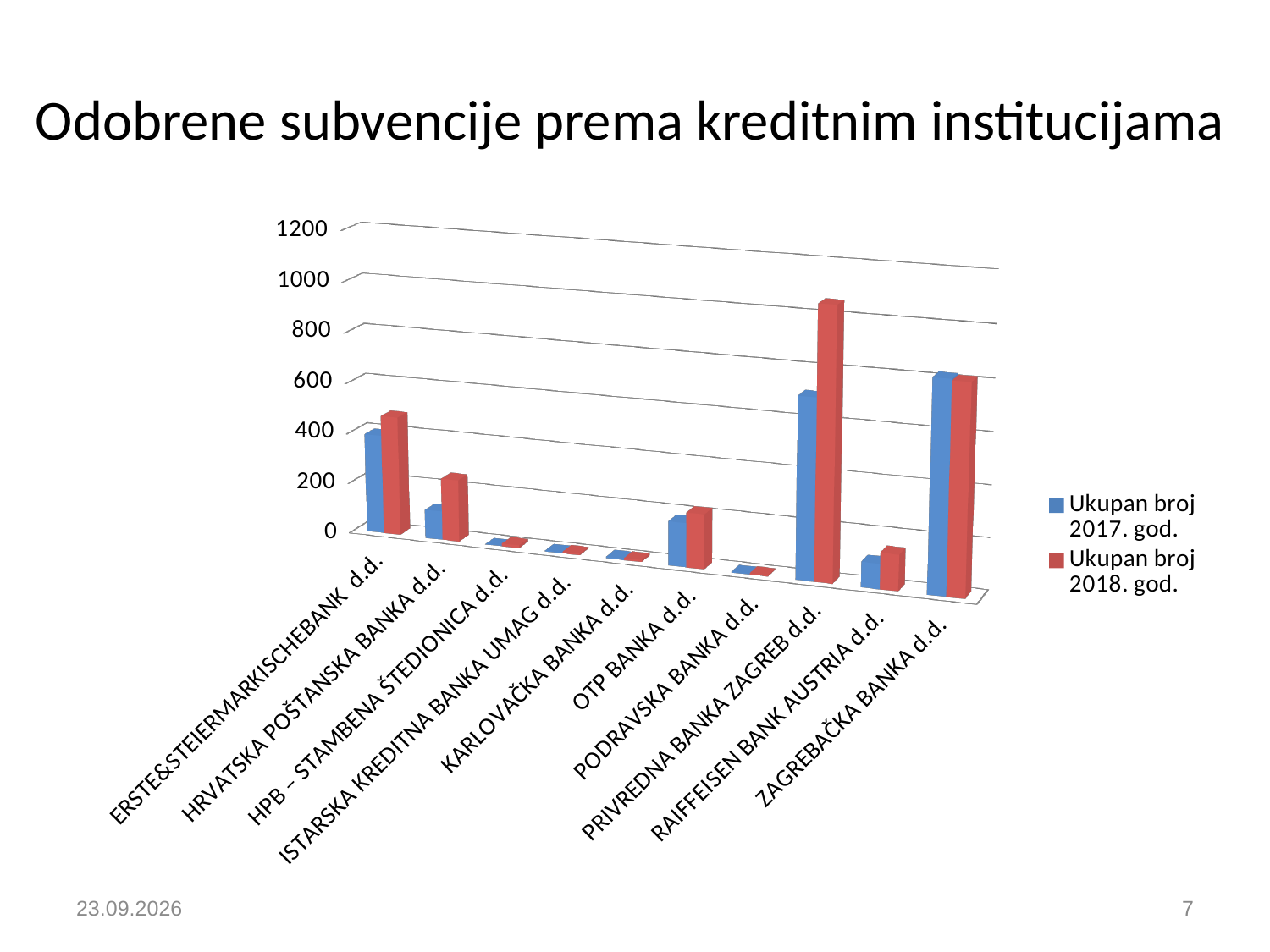
For ERSTE&STEIERMARKISCHEBANK d.d., which series has the larger value: Ukupan broj 2017. god. or Ukupan broj 2018. god.? Ukupan broj 2018. god. Which credit institution has the highest value for Ukupan broj 2018. god.? PRIVREDNA BANKA ZAGREB d.d. What is the title of the chart on the slide? Odobrene subvencije prema kreditnim institucijama Is the value for ZAGREBAČKA BANKA d.d. in Ukupan broj 2017. god. greater or less than 400? greater Is the value for HRVATSKA POŠTANSKA BANKA d.d. in Ukupan broj 2018. god. greater or less than 400? less For PRIVREDNA BANKA ZAGREB d.d., which series has the larger value: Ukupan broj 2017. god. or Ukupan broj 2018. god.? Ukupan broj 2018. god. What kind of chart is shown on the slide? bar chart How many credit institutions (categories) are shown on the x axis? 10 Is the value for RAIFFEISEN BANK AUSTRIA d.d. in Ukupan broj 2018. god. greater or less than 200? less How many series does the legend list? 2